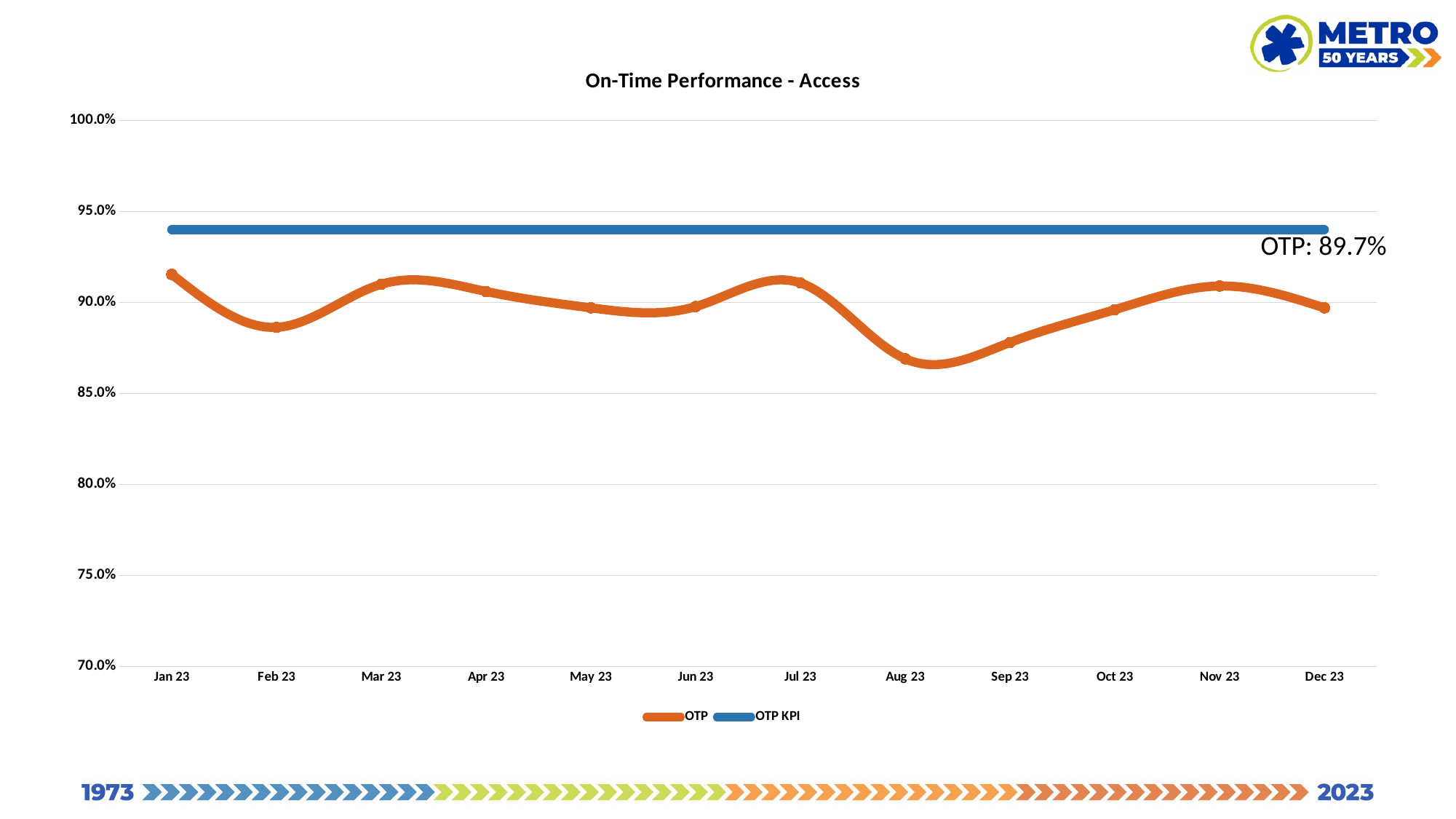
What colour is the OTP KPI line? blue How many months are plotted along the x axis? 12 What OTP value is printed on the chart for Dec 23? 89.7% Is the OTP value for Jan 23 greater or less than 90.0%? greater Which month has the lowest OTP value? Aug 23 Is the OTP KPI line greater or less than 95.0%? less Between Jul 23 and Aug 23, does the OTP line rise or fall? fall Which is larger, the OTP value for Mar 23 or for Feb 23? Mar 23 Is the OTP value for Aug 23 greater or less than 90.0%? less How many series does the legend list? 2 What kind of chart is shown on the slide? line chart What is the title of the chart? On-Time Performance - Access